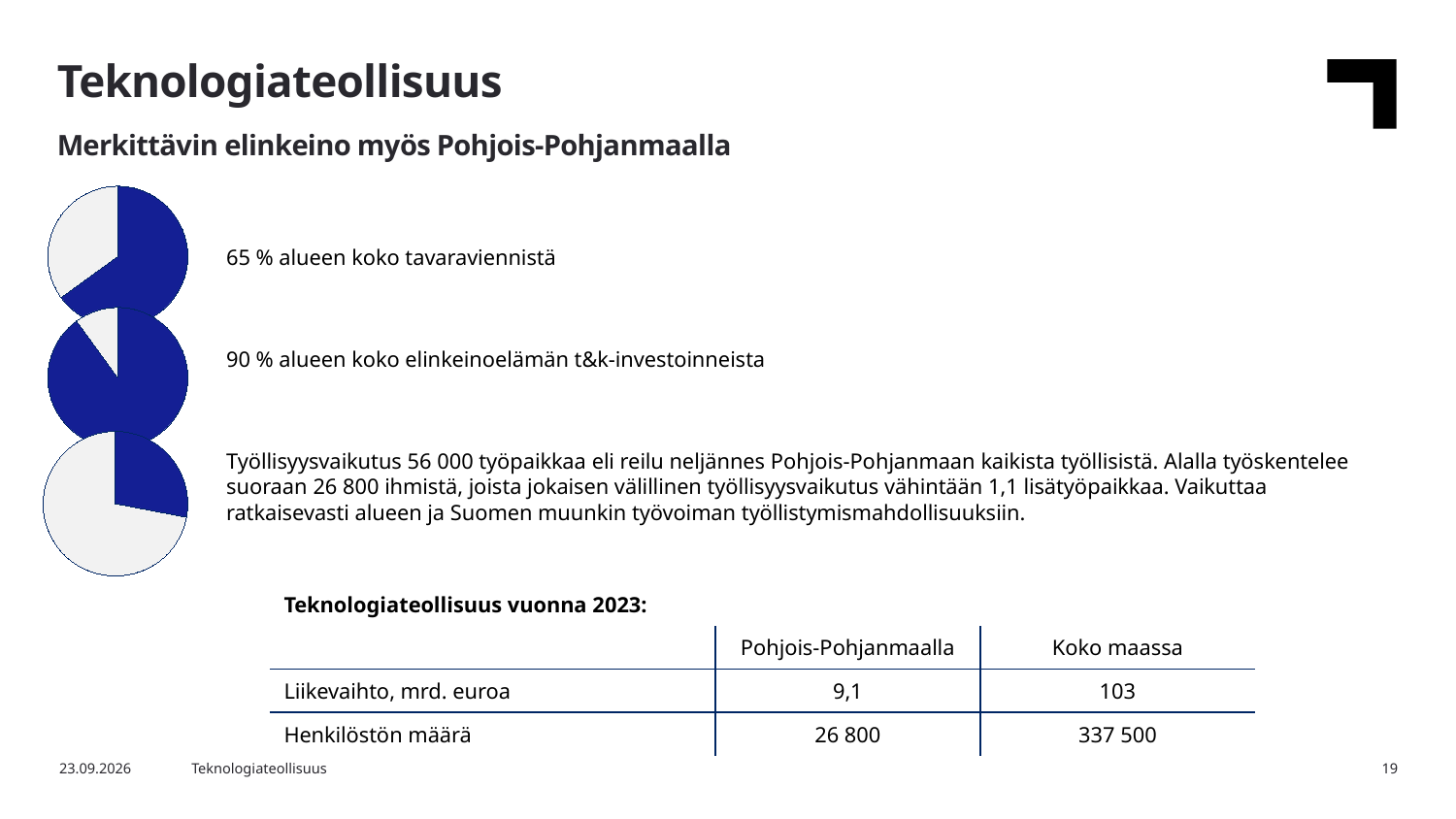
Is the blue share in the top pie chart larger or smaller than the blue share in the middle pie chart? Smaller Which pie chart has the smallest blue (filled) share: the top, middle or bottom one? Bottom What kind of charts are shown on the left side of the slide? Pie charts What is the main title of the slide containing the pie charts? Teknologiateollisuus According to the text next to the middle pie chart, what share of the region's business R&D investments does the technology industry account for? 90 % What is the difference between the share shown for the top pie chart (goods exports) and the middle pie chart (R&D investments)? 25 percentage points What colour is used for the highlighted slice in the pie charts? Blue Is the blue share in the middle pie chart greater or less than 75%? greater How many pie charts are on the slide? 3 Is the blue share in the bottom pie chart greater or less than 50%? less According to the text next to the top pie chart, what share of the region's total goods exports does the technology industry account for? 65 % Which pie chart has the largest blue (filled) share: the top, middle or bottom one? Middle